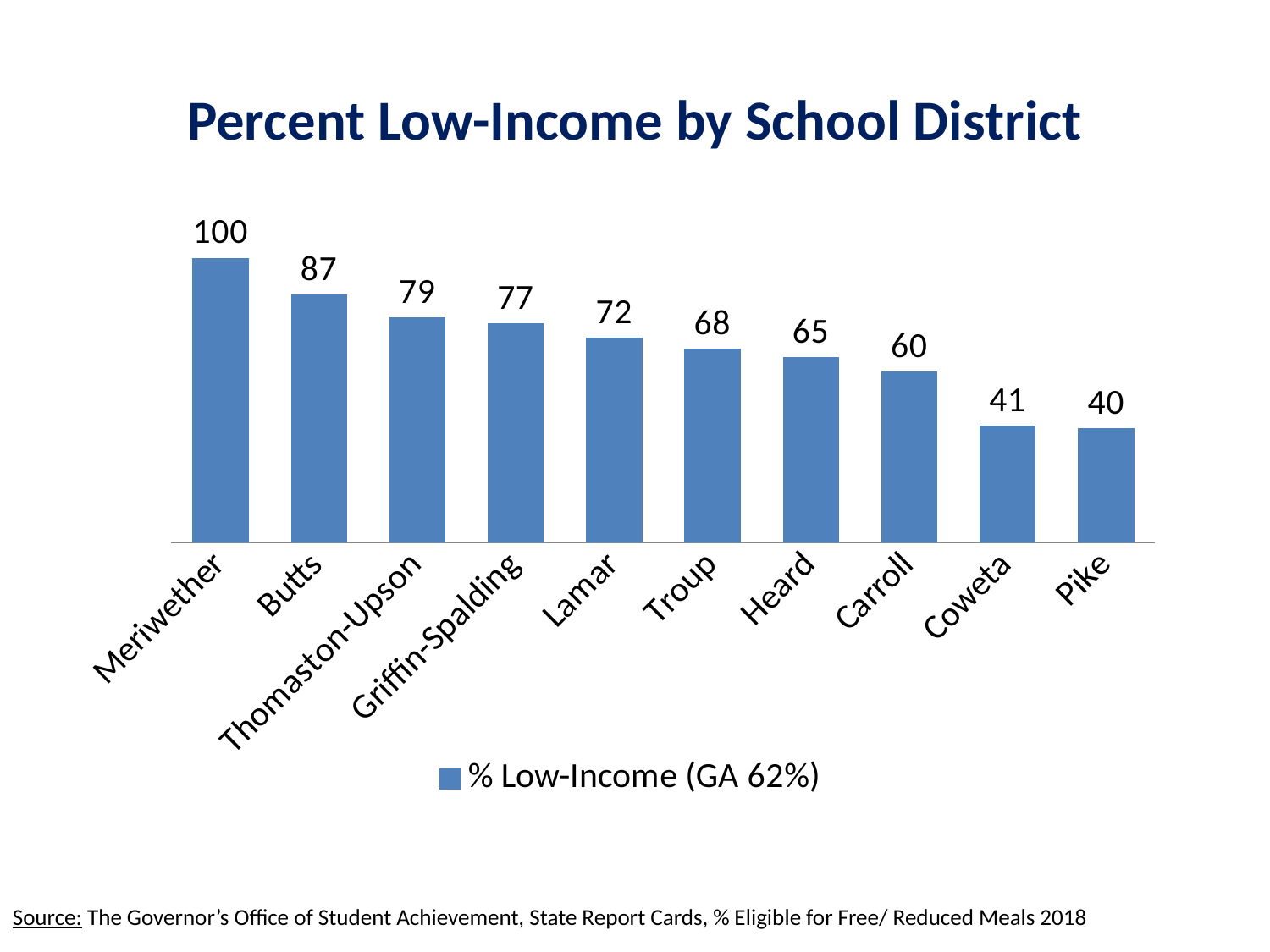
What is the percent low-income value for Troup? 68 What is the difference between the values for Butts and Carroll? 27 What is the difference between the values for Thomaston-Upson and Griffin-Spalding? 2 Which school district has the highest percent low-income? Meriwether Which school district has the lowest percent low-income? Pike What is the percent low-income value for Meriwether? 100 Do the values rise or fall from left to right across the districts? Fall How many school districts are shown in the chart? 10 How many series does the legend list? 1 What kind of chart is shown on the slide? Bar chart Which has a higher percent low-income, Lamar or Heard? Lamar What is the percent low-income value for Coweta? 41